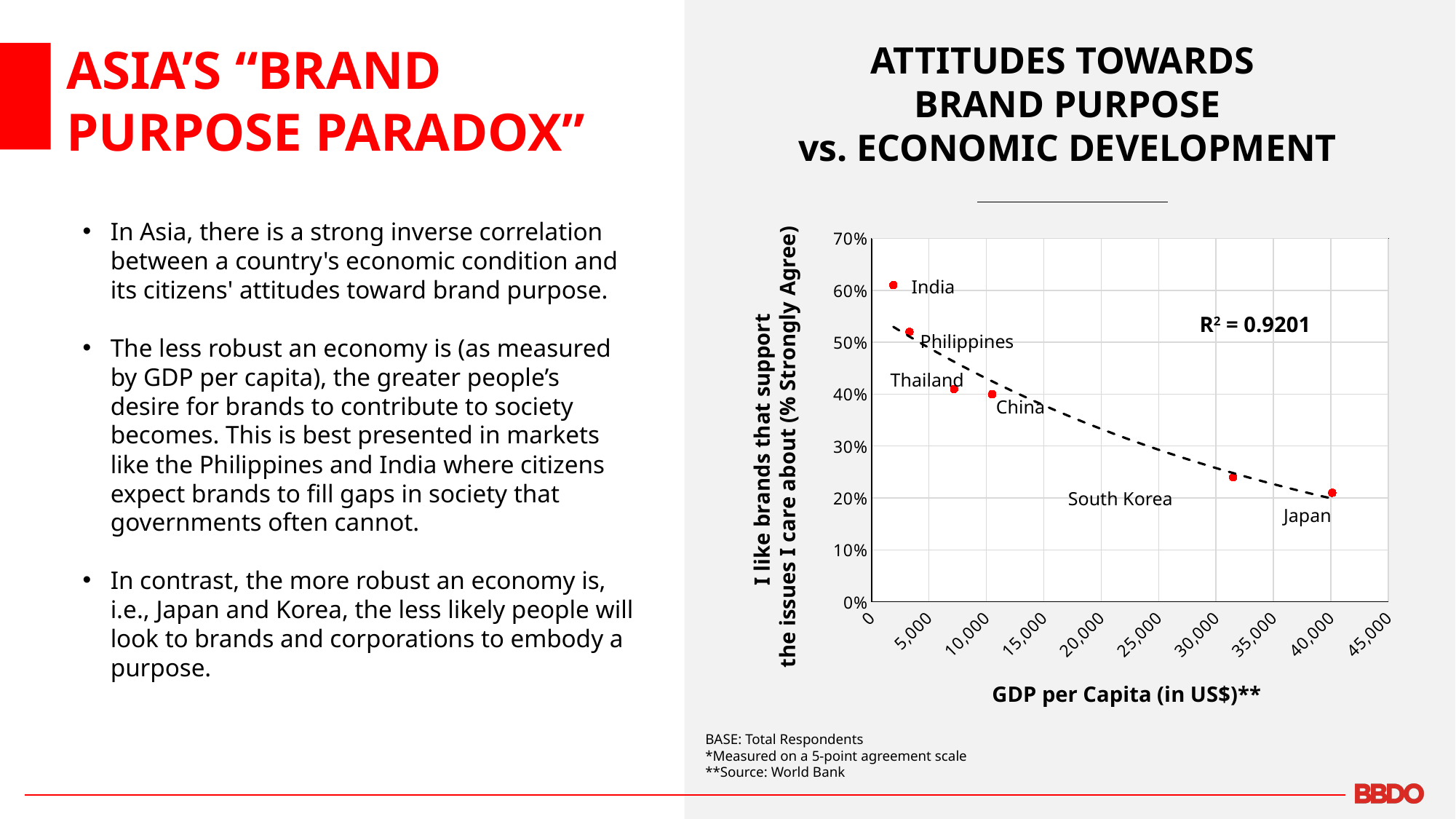
What kind of chart is shown on the slide? scatter plot Is the GDP per capita for Japan greater or less than 35,000? greater Which country has the lowest percentage of people who strongly agree they like brands that support the issues they care about? Japan How many countries are plotted on the chart? 6 What R² value is shown on the chart? R² = 0.9201 Which has a higher percentage of strong agreement, Philippines or South Korea? Philippines Is the GDP per capita for India greater or less than 5,000? less Is the percentage value for South Korea greater or less than 30%? less Which has a higher percentage of strong agreement, India or Japan? India As GDP per capita increases along the x axis, do the percentage values rise or fall? fall Which country has the highest percentage of people who strongly agree they like brands that support the issues they care about? India